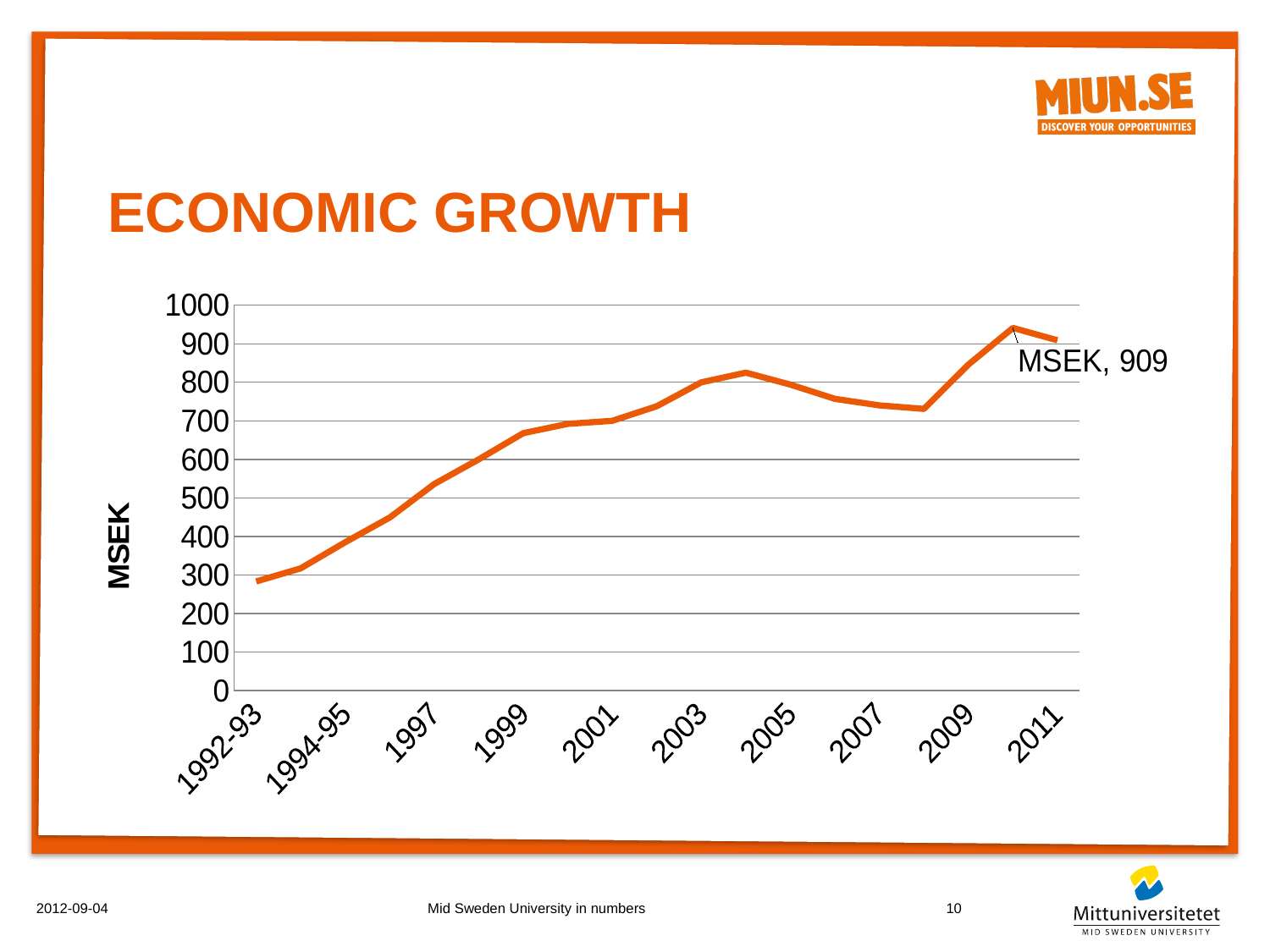
Is the value for 1992-93 greater or less than 400? less Is the value for 2001 greater or less than 800? less Which is larger, the value for 2011 or the value for 1992-93? 2011 Which is larger, the value for 2003 or the value for 2007? 2003 Is the value for 2011 greater or less than 900? greater What is the label on the vertical axis? MSEK What kind of chart is shown on the slide? line chart Do the values rise or fall from 1992-93 to 1999? rise What is the title of the chart? ECONOMIC GROWTH What is the value for 2011 according to the data label? 909